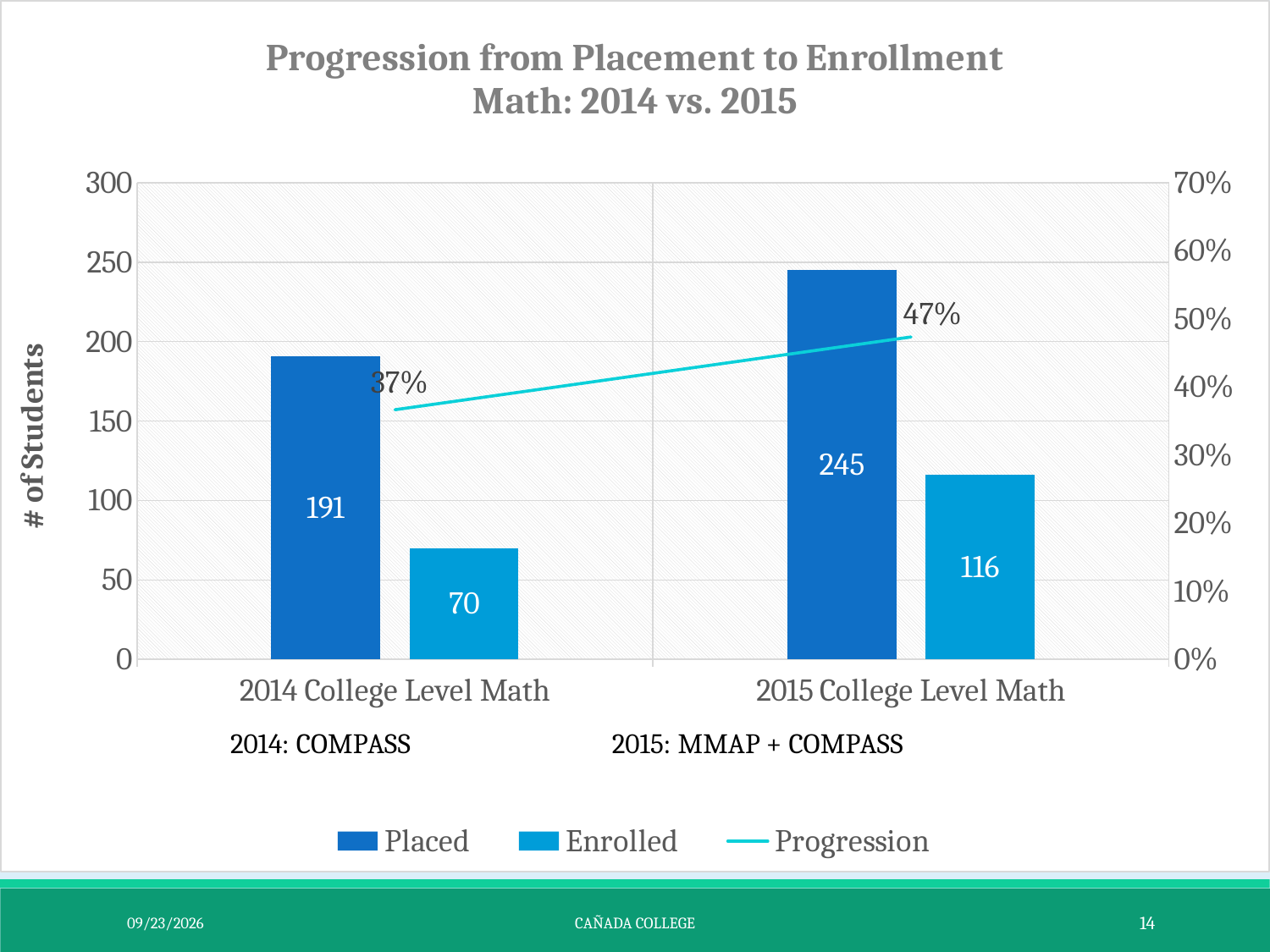
What is the Progression percentage for 2015 College Level Math? 47% How many series does the legend list? 3 Does the Progression line rise or fall from 2014 to 2015? rise What is the difference between Placed and Enrolled students in 2014 College Level Math? 121 Which category has the lower number of Enrolled students? 2014 College Level Math What is the Progression percentage for 2014 College Level Math? 37% Is the number of Placed students in 2015 College Level Math greater or less than 200? greater How many students were Placed in 2014 College Level Math? 191 How many students were Enrolled in 2015 College Level Math? 116 What is the label of the left vertical axis? # of Students How much did the number of Enrolled students increase from 2014 to 2015 College Level Math? 46 Which category has the higher number of Placed students? 2015 College Level Math